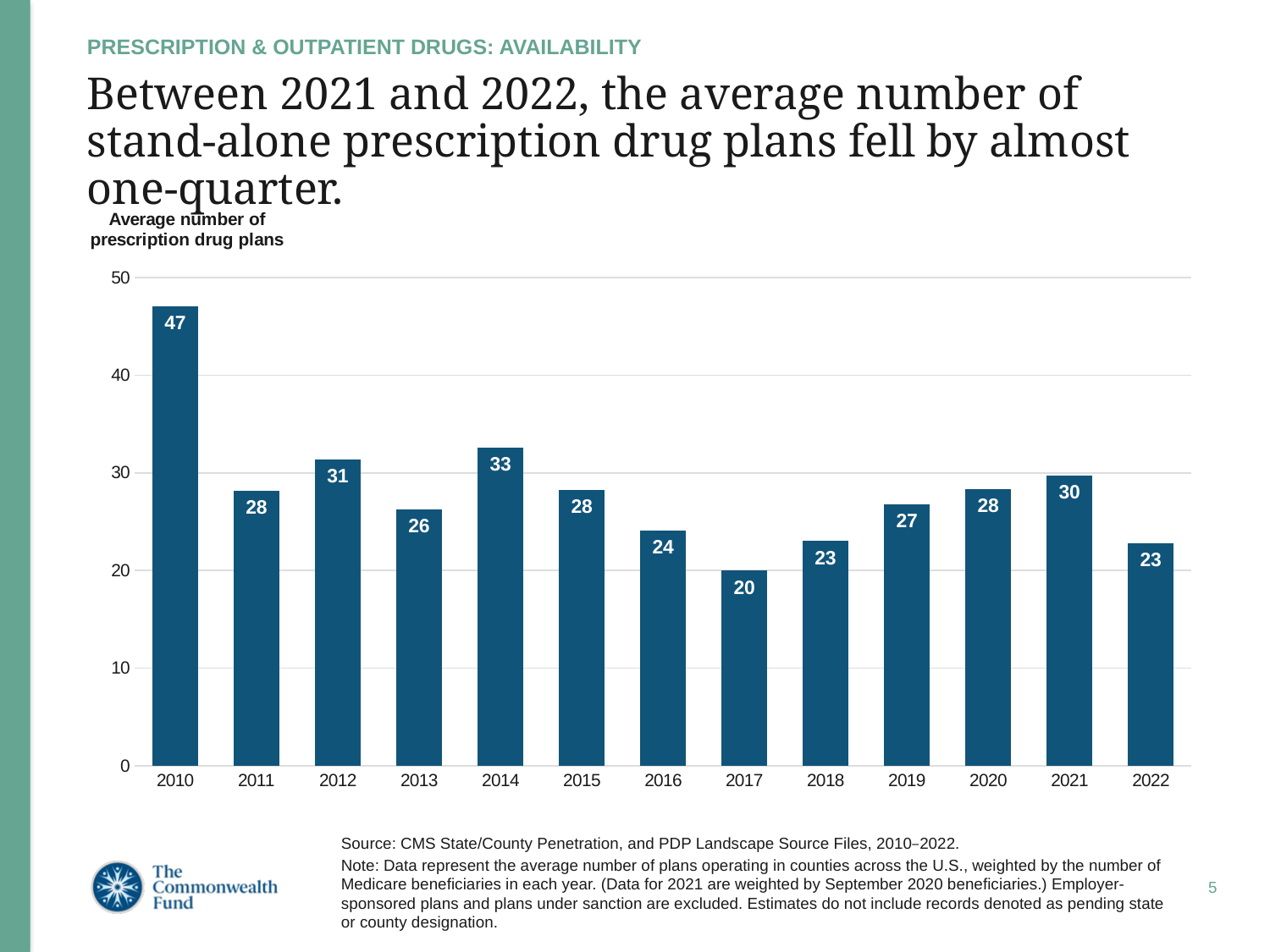
What is the difference between the average number of prescription drug plans in 2021 and 2022? 7 Which year has the lowest average number of prescription drug plans? 2017 What is the average number of prescription drug plans in 2010? 47 Is the value for 2012 greater or less than 30? greater What is the average number of prescription drug plans in 2022? 23 Which year has a larger average number of prescription drug plans, 2014 or 2019? 2014 What kind of chart is shown on the slide? bar chart Does the average number of prescription drug plans rise or fall from 2017 to 2021? rise Which year has the highest average number of prescription drug plans? 2010 How many years are shown on the x axis of the chart? 13 What is the average number of prescription drug plans in 2017? 20 What is the label of the y axis of the chart? Average number of prescription drug plans